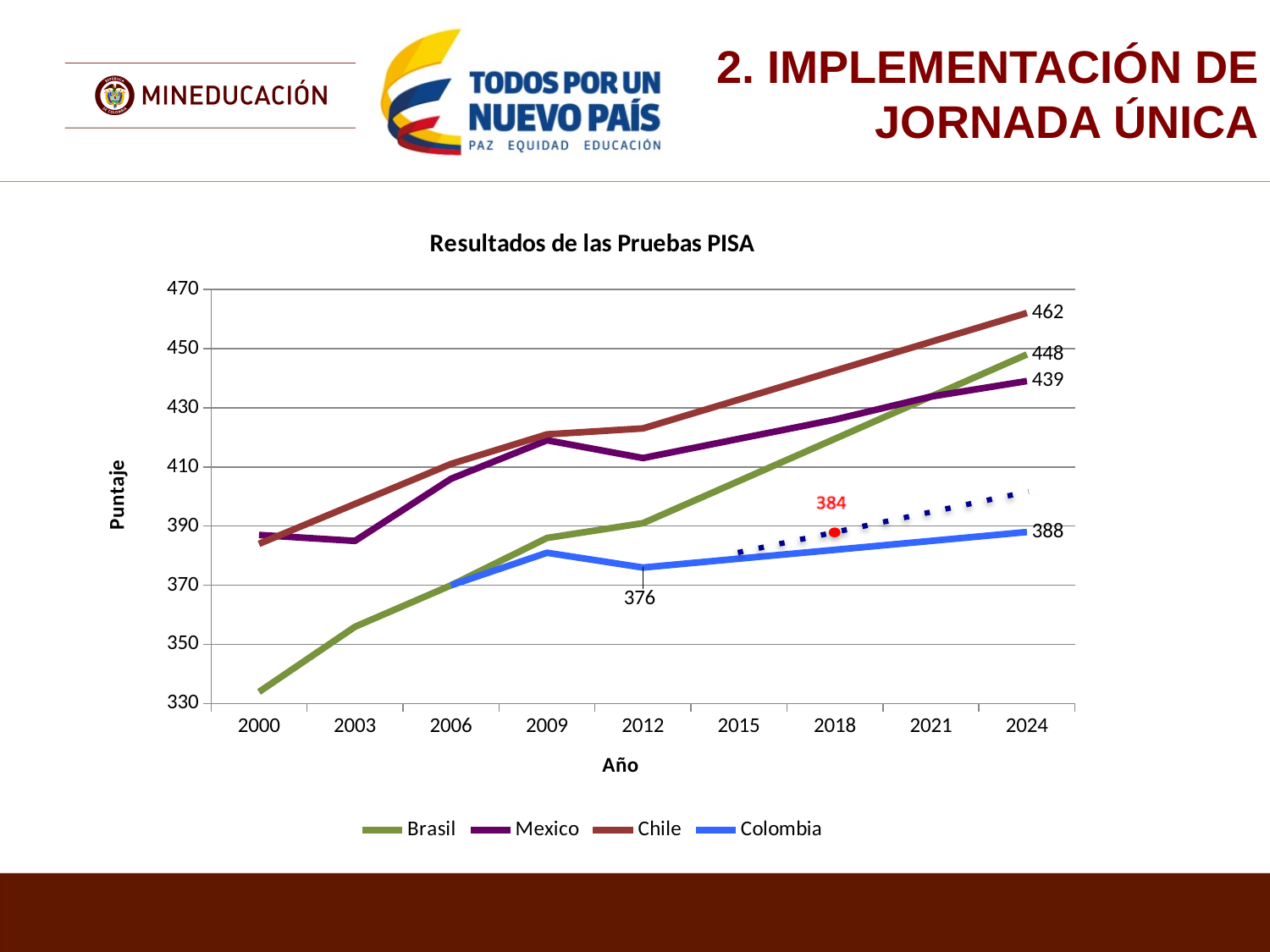
What is the title of the chart? Resultados de las Pruebas PISA Which series has the highest value in 2024? Chile Does the Brasil line rise or fall from 2000 to 2024? rise What type of chart is shown on the slide? line chart Is the value for Brasil in 2000 greater or less than 350? less What is the value for Colombia in 2012? 376 What is the value for Chile in 2024? 462 Which series has the lowest value in 2024? Colombia What is the value for Brasil in 2024? 448 Which is larger in 2024, the value for Brasil or the value for Mexico? Brasil How many series does the legend list? 4 What is the difference between the values for Chile and Colombia in 2024? 74